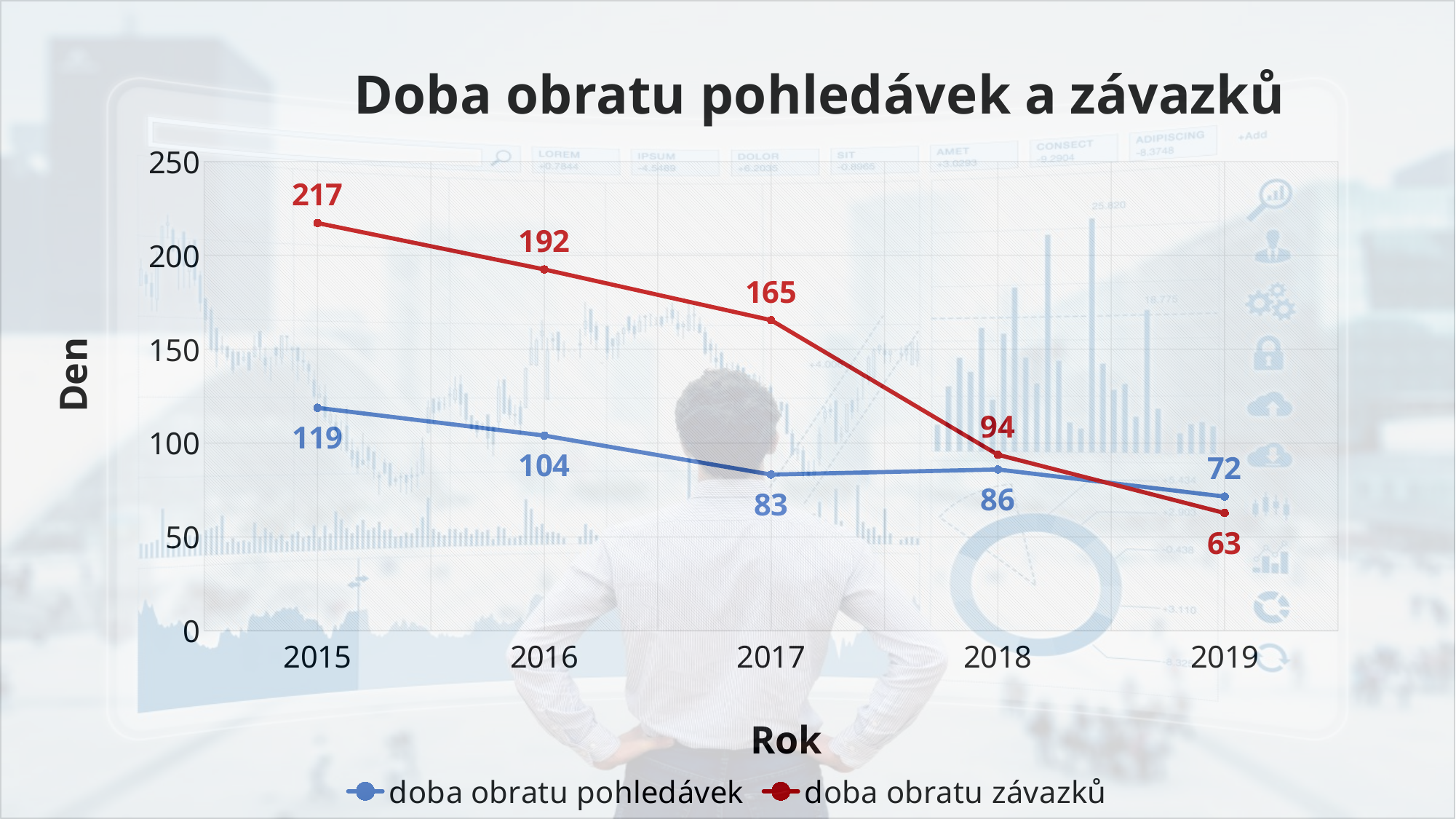
In which year is doba obratu závazků highest? 2015 How many years are shown on the x axis? 5 How many series does the legend list? 2 What is the value of doba obratu pohledávek in 2019? 72 What is the value of doba obratu závazků in 2015? 217 Is the value of doba obratu závazků in 2017 greater or less than 150? greater Does doba obratu závazků rise or fall from 2015 to 2019? fall Which is larger in 2019, doba obratu pohledávek or doba obratu závazků? doba obratu pohledávek In which year is doba obratu pohledávek lowest? 2019 What is the difference between doba obratu závazků and doba obratu pohledávek in 2016? 88 What is the value of doba obratu pohledávek in 2017? 83 What kind of chart is shown on the slide? line chart